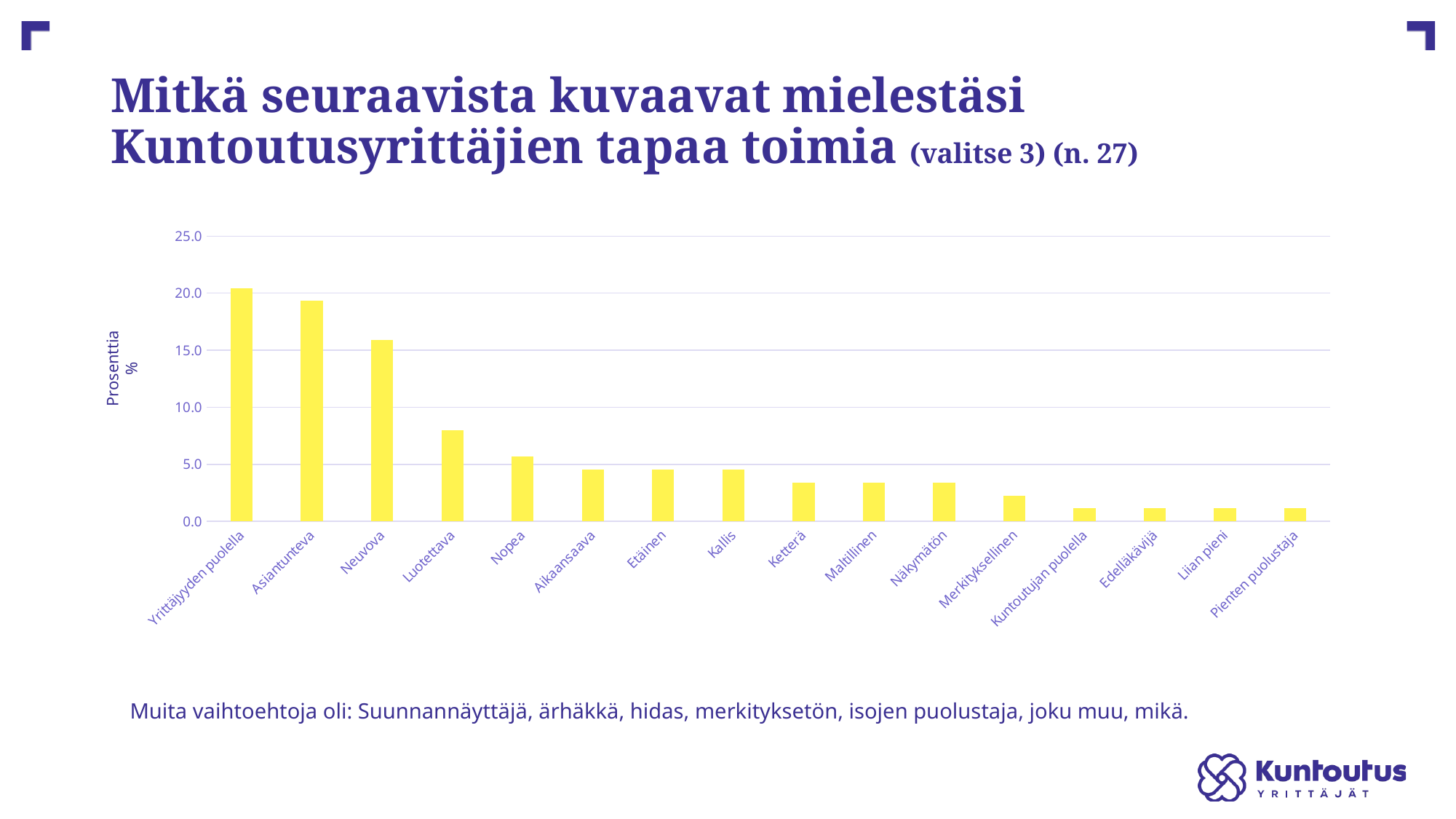
Is the value for Asiantunteva greater or less than 15.0? greater Is the value for Luotettava greater or less than 10.0? less Is the value for Yrittäjyyden puolella greater or less than 15.0? greater What is the label of the y axis of the chart? Prosenttia % What kind of chart is shown on the slide? bar chart Which has a larger value, Nopea or Ketterä? Nopea Do the bar values rise or fall from left to right along the x axis? fall Which has a larger value, Neuvova or Luotettava? Neuvova Which category has the highest value in the chart? Yrittäjyyden puolella How many categories are shown on the x axis of the chart? 16